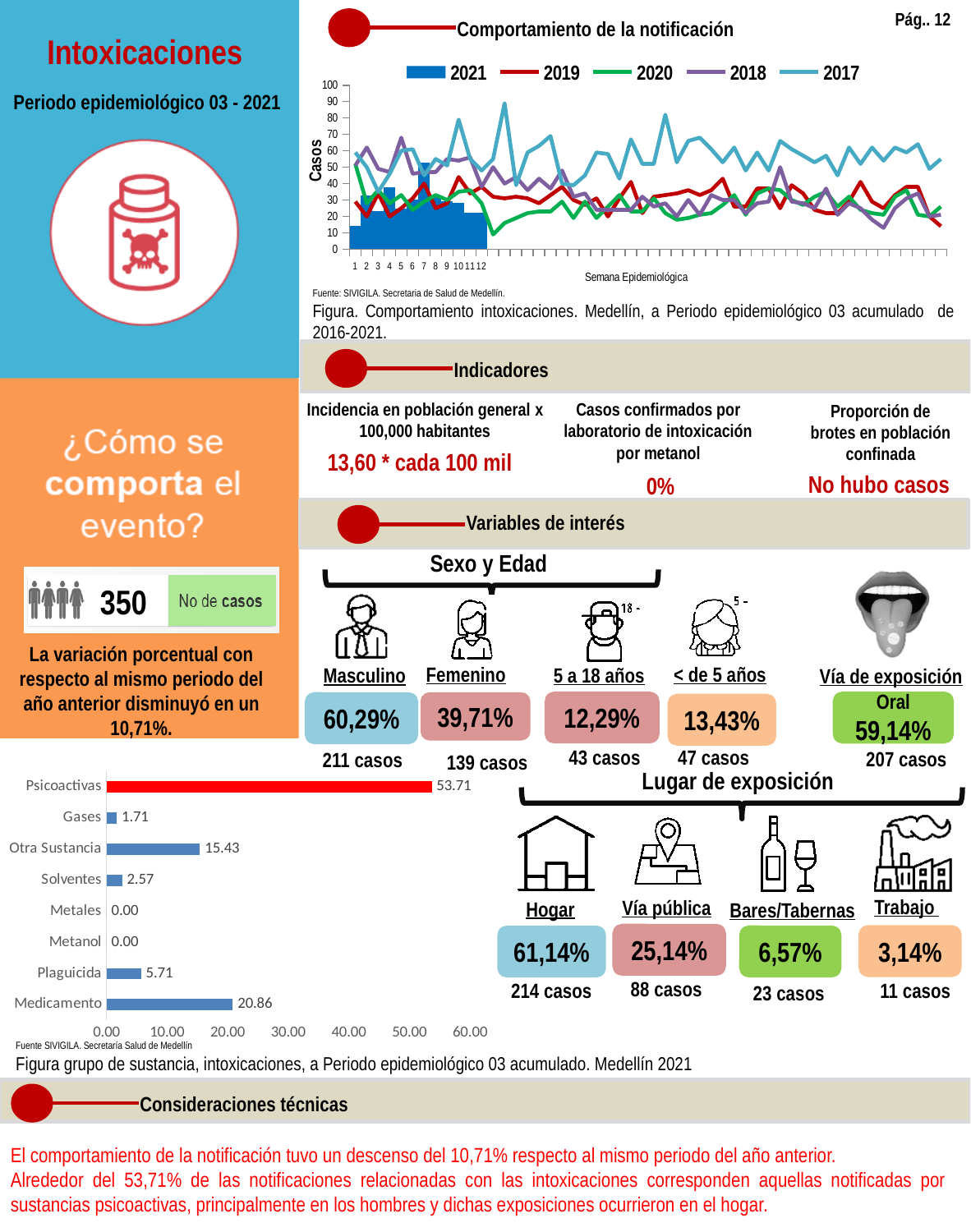
What kind of chart is the bottom-left chart of substance groups? Bar chart In the bottom-left bar chart of substance groups, which bar is coloured red instead of blue? Psicoactivas In the bottom-left bar chart of substance groups, what is the value for Otra Sustancia? 15.43 In the bottom-left bar chart of substance groups, what is the difference between the values for Psicoactivas and Medicamento? 32.85 In the bottom-left bar chart of substance groups, which is larger: the value for Medicamento or for Otra Sustancia? Medicamento How many series does the legend of the top chart 'Comportamiento de la notificación' list? 5 In the bottom-left bar chart of substance groups, what is the value for Psicoactivas? 53.71 In the top chart 'Comportamiento de la notificación', is the value for 2017 at week 7 greater or less than 80? less In the bottom-left bar chart of substance groups, which category has the highest value? Psicoactivas How many categories are shown in the bottom-left bar chart of substance groups? 8 In the bottom-left bar chart of substance groups, which two categories have a value of 0.00? Metales and Metanol In the bottom-left bar chart of substance groups, what is the value for Medicamento? 20.86